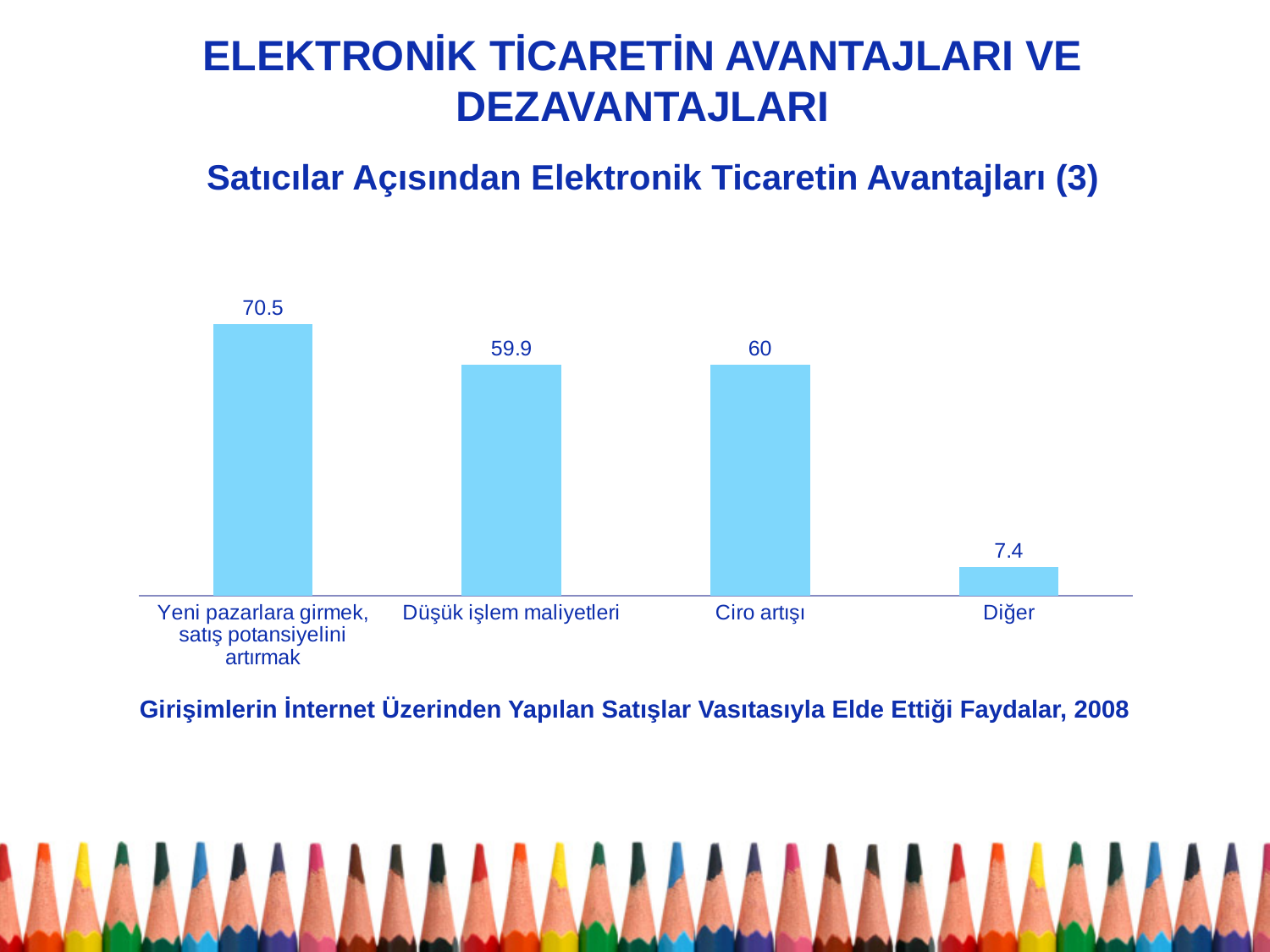
What is the value for "Diğer"? 7.4 What is the value for "Ciro artışı"? 60 What is the value for "Yeni pazarlara girmek, satış potansiyelini artırmak"? 70.5 What is the difference between the values for "Yeni pazarlara girmek, satış potansiyelini artırmak" and "Ciro artışı"? 10.5 What kind of chart is shown on the slide? Bar chart What is the value for "Düşük işlem maliyetleri"? 59.9 What is the difference between the values for "Düşük işlem maliyetleri" and "Diğer"? 52.5 Which category has the lowest value? Diğer Which is larger, the value for "Yeni pazarlara girmek, satış potansiyelini artırmak" or the value for "Düşük işlem maliyetleri"? Yeni pazarlara girmek, satış potansiyelini artırmak What is the caption printed below the chart? Girişimlerin İnternet Üzerinden Yapılan Satışlar Vasıtasıyla Elde Ettiği Faydalar, 2008 Which category has the highest value? Yeni pazarlara girmek, satış potansiyelini artırmak How many categories are shown in the chart? 4